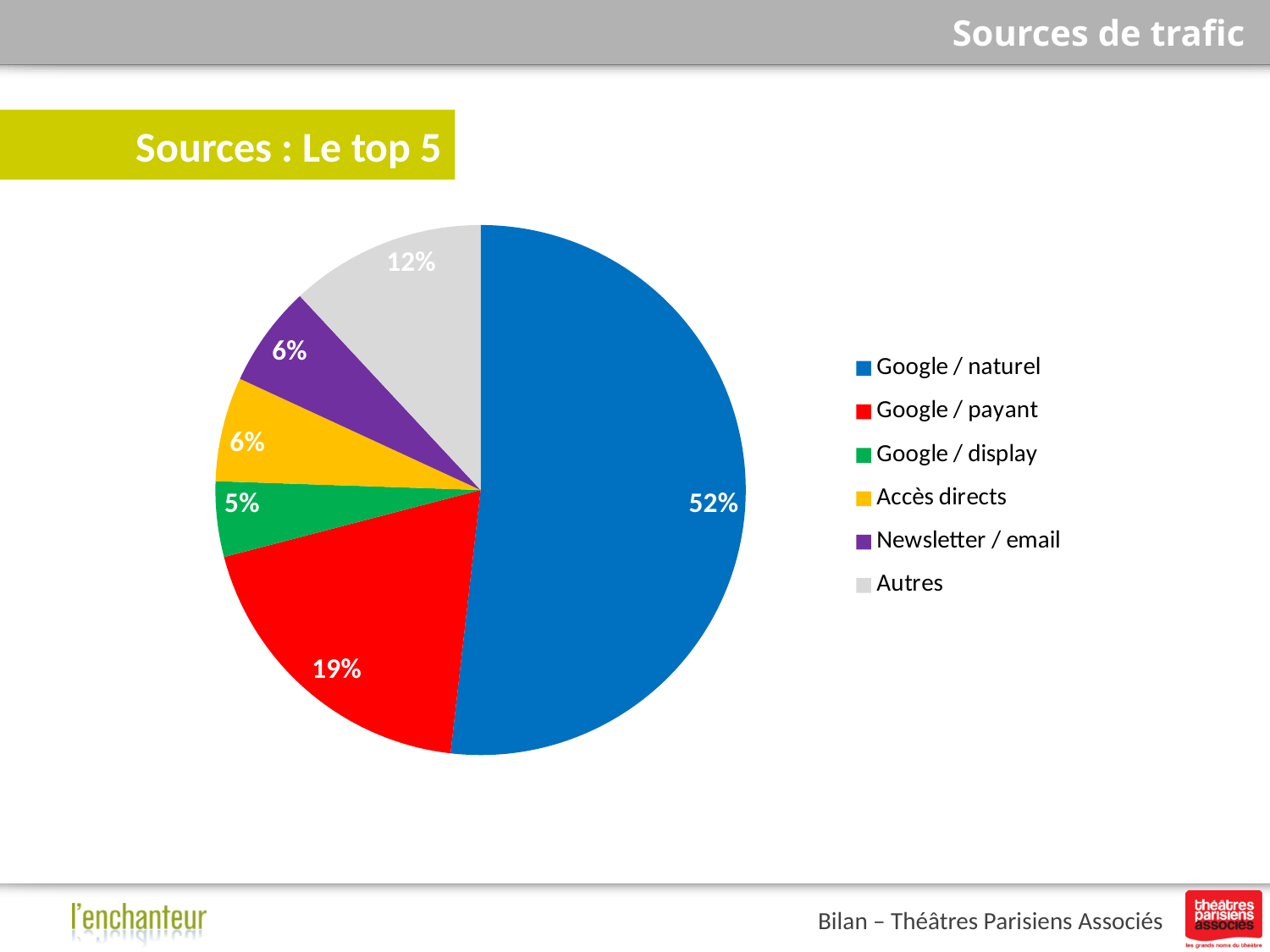
Which has a larger share, Autres or Newsletter / email? Autres Which traffic source has the largest share? Google / naturel What kind of chart is shown on the slide? Pie chart What share of traffic does Autres account for? 12% Which traffic source has the smallest share? Google / display What share of traffic does Google / display account for? 5% What is the title shown above the chart? Sources : Le top 5 What share of traffic does Google / payant account for? 19% What is the difference in share between Google / naturel and Google / payant? 33% What colour is the Accès directs slice? Yellow What share of traffic does Google / naturel account for? 52% How many categories does the pie chart show? 6